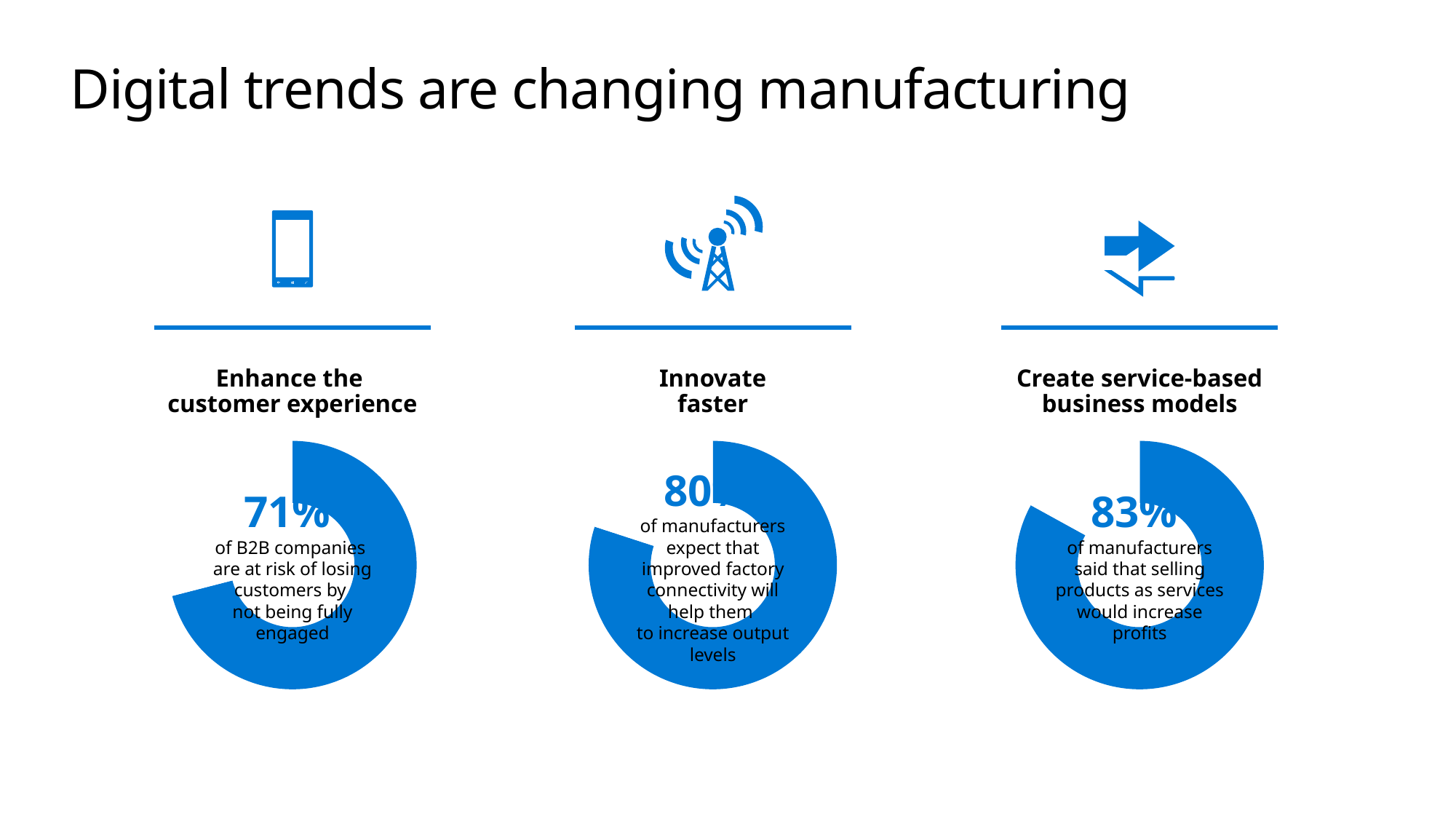
What is the difference between the percentage on the 'Create service-based business models' chart and the percentage on the 'Enhance the customer experience' chart? 12% What colour is the filled portion of the donut charts on the slide? Blue What is the title of the slide containing the three donut charts? Digital trends are changing manufacturing Is the value on the 'Innovate faster' chart greater or less than 50%? greater Which is larger: the percentage on the 'Enhance the customer experience' chart or the percentage on the 'Create service-based business models' chart? Create service-based business models Which of the three charts shows the highest percentage? Create service-based business models On the 'Create service-based business models' chart, what percentage of manufacturers said that selling products as services would increase profits? 83% Which of the three charts shows the lowest percentage? Enhance the customer experience On the 'Enhance the customer experience' chart, what percentage of B2B companies are at risk of losing customers by not being fully engaged? 71% How many donut charts are shown on the slide? 3 What kind of chart is used under each of the three headings on the slide? Donut (pie) chart Is the value on the 'Enhance the customer experience' chart greater or less than 50%? greater